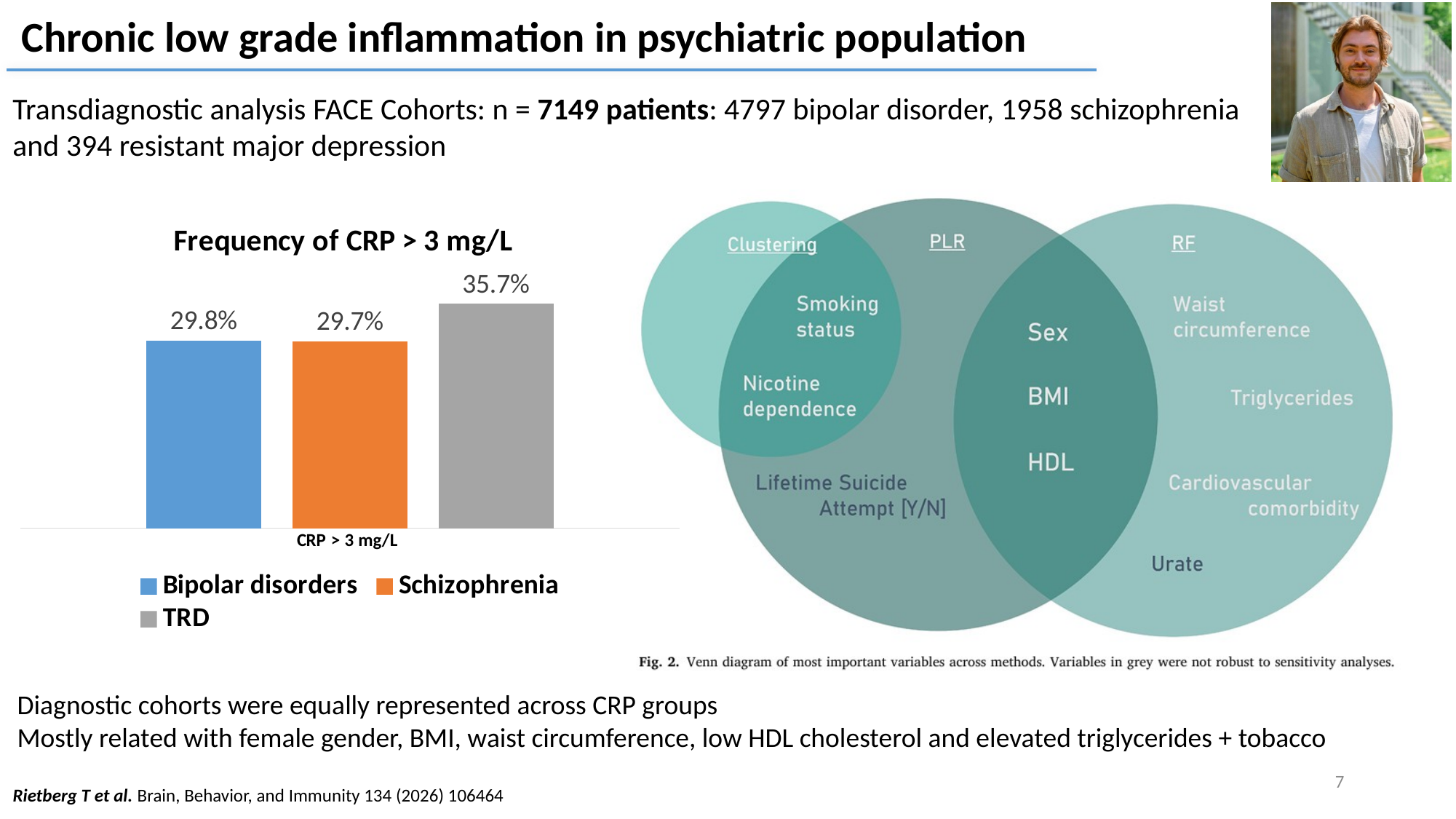
In the chart 'Frequency of CRP > 3 mg/L', how many bars are plotted? 3 In the chart 'Frequency of CRP > 3 mg/L', what is the value for Bipolar disorders? 29.8% In the chart 'Frequency of CRP > 3 mg/L', how many series does the legend list? 3 In the chart 'Frequency of CRP > 3 mg/L', what is the difference between the TRD value and the Bipolar disorders value? 5.9% What kind of chart is 'Frequency of CRP > 3 mg/L'? Bar chart In the chart 'Frequency of CRP > 3 mg/L', what is the category label shown under the bars on the x axis? CRP > 3 mg/L In the chart 'Frequency of CRP > 3 mg/L', which is larger, the value for TRD or the value for Bipolar disorders? TRD In the chart 'Frequency of CRP > 3 mg/L', which group has the highest frequency? TRD In the chart 'Frequency of CRP > 3 mg/L', what colour is the Schizophrenia bar? Orange In the chart 'Frequency of CRP > 3 mg/L', what is the value for TRD? 35.7% In the chart 'Frequency of CRP > 3 mg/L', what is the value for Schizophrenia? 29.7%